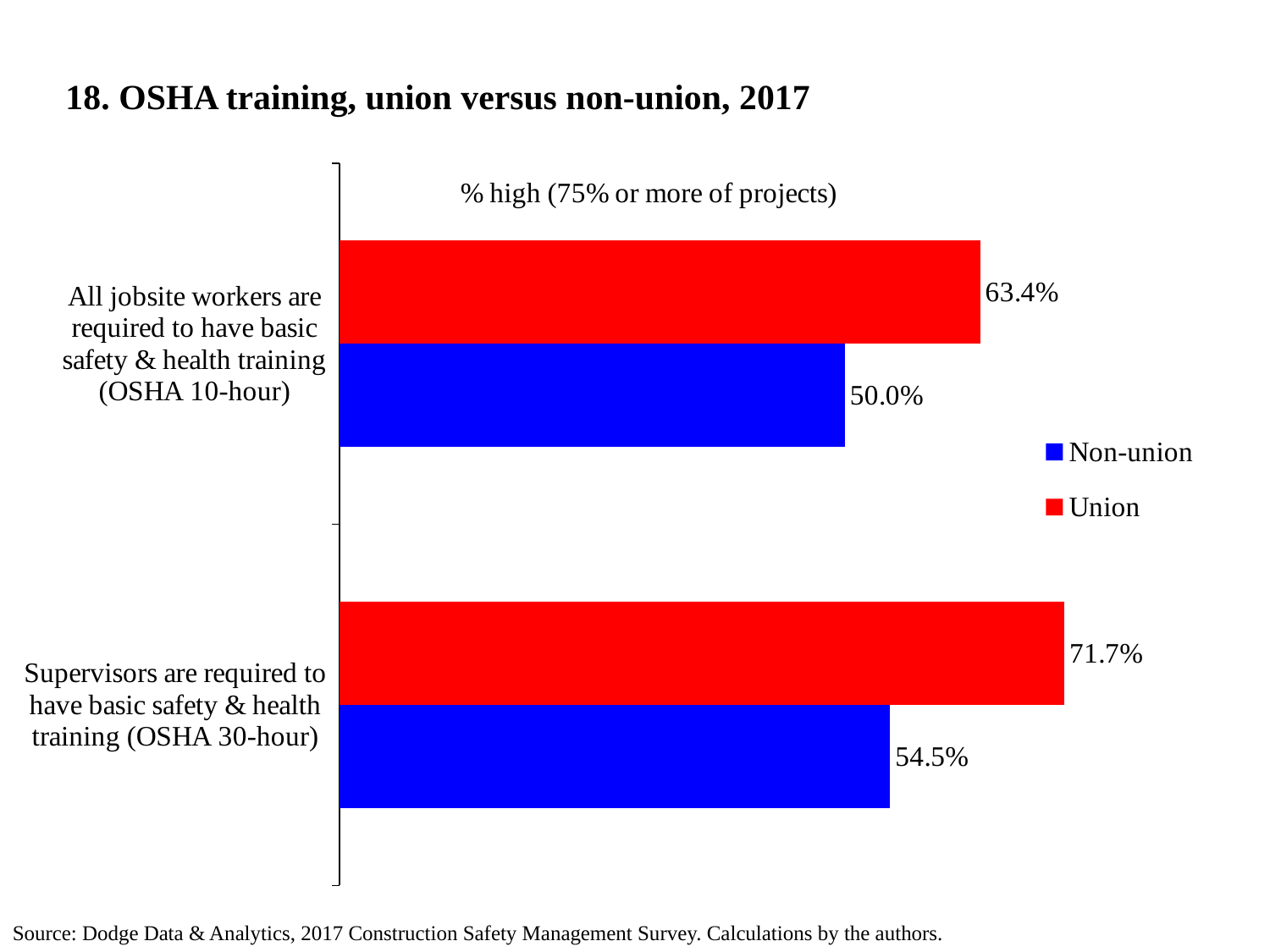
What kind of chart is shown on the slide? Bar chart What is the Non-union value for 'All jobsite workers are required to have basic safety & health training (OSHA 10-hour)'? 50.0% What is the difference between the Union and Non-union values for the OSHA 10-hour jobsite worker training category? 13.4% Which bar has the lowest value on the chart? Non-union, All jobsite workers are required to have basic safety & health training (OSHA 10-hour) What is the Union value for 'All jobsite workers are required to have basic safety & health training (OSHA 10-hour)'? 63.4% What is the Non-union value for 'Supervisors are required to have basic safety & health training (OSHA 30-hour)'? 54.5% What is the Union value for 'Supervisors are required to have basic safety & health training (OSHA 30-hour)'? 71.7% How many series does the legend list? 2 Which is larger: the Union value for OSHA 10-hour training or the Non-union value for OSHA 30-hour training? Union value for OSHA 10-hour training How many categories are shown on the chart? 2 What is the difference between the Union and Non-union values for the OSHA 30-hour supervisor training category? 17.2% Which bar has the highest value on the chart? Union, Supervisors are required to have basic safety & health training (OSHA 30-hour)